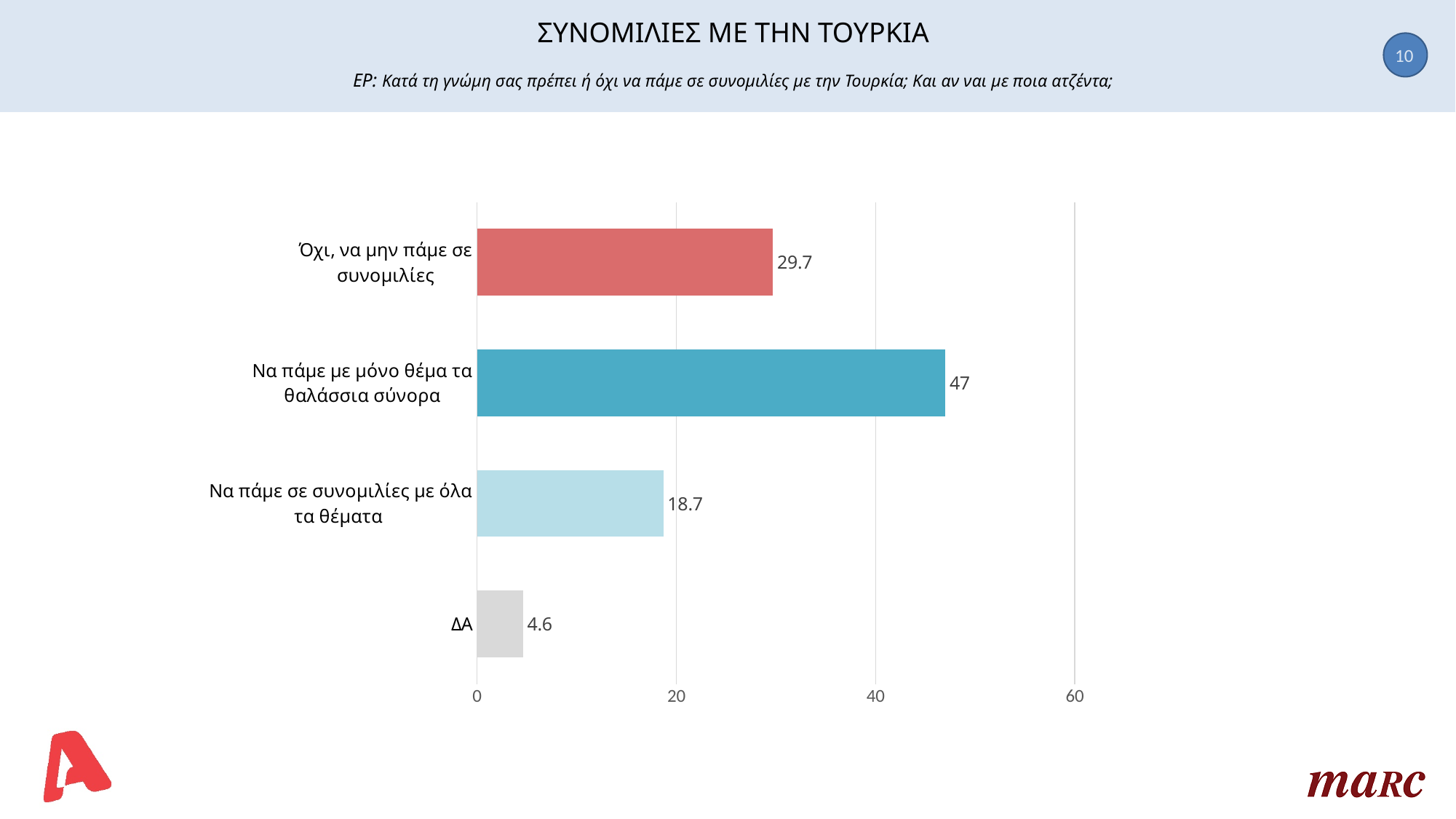
Is the value for "Να πάμε με μόνο θέμα τα θαλάσσια σύνορα" greater or less than 40? greater Which category has the lowest value? ΔΑ What kind of chart is shown on the slide? bar chart What is the value for "Να πάμε σε συνομιλίες με όλα τα θέματα"? 18.7 What is the value for "Να πάμε με μόνο θέμα τα θαλάσσια σύνορα"? 47 What is the value for "ΔΑ"? 4.6 How many categories are shown in the chart? 4 What is the difference between the values for "Να πάμε με μόνο θέμα τα θαλάσσια σύνορα" and "Όχι, να μην πάμε σε συνομιλίες"? 17.3 Which is larger: the value for "Όχι, να μην πάμε σε συνομιλίες" or for "Να πάμε σε συνομιλίες με όλα τα θέματα"? Όχι, να μην πάμε σε συνομιλίες Which category has the highest value? Να πάμε με μόνο θέμα τα θαλάσσια σύνορα What is the title of the slide? ΣΥΝΟΜΙΛΙΕΣ ΜΕ ΤΗΝ ΤΟΥΡΚΙΑ What is the value for "Όχι, να μην πάμε σε συνομιλίες"? 29.7